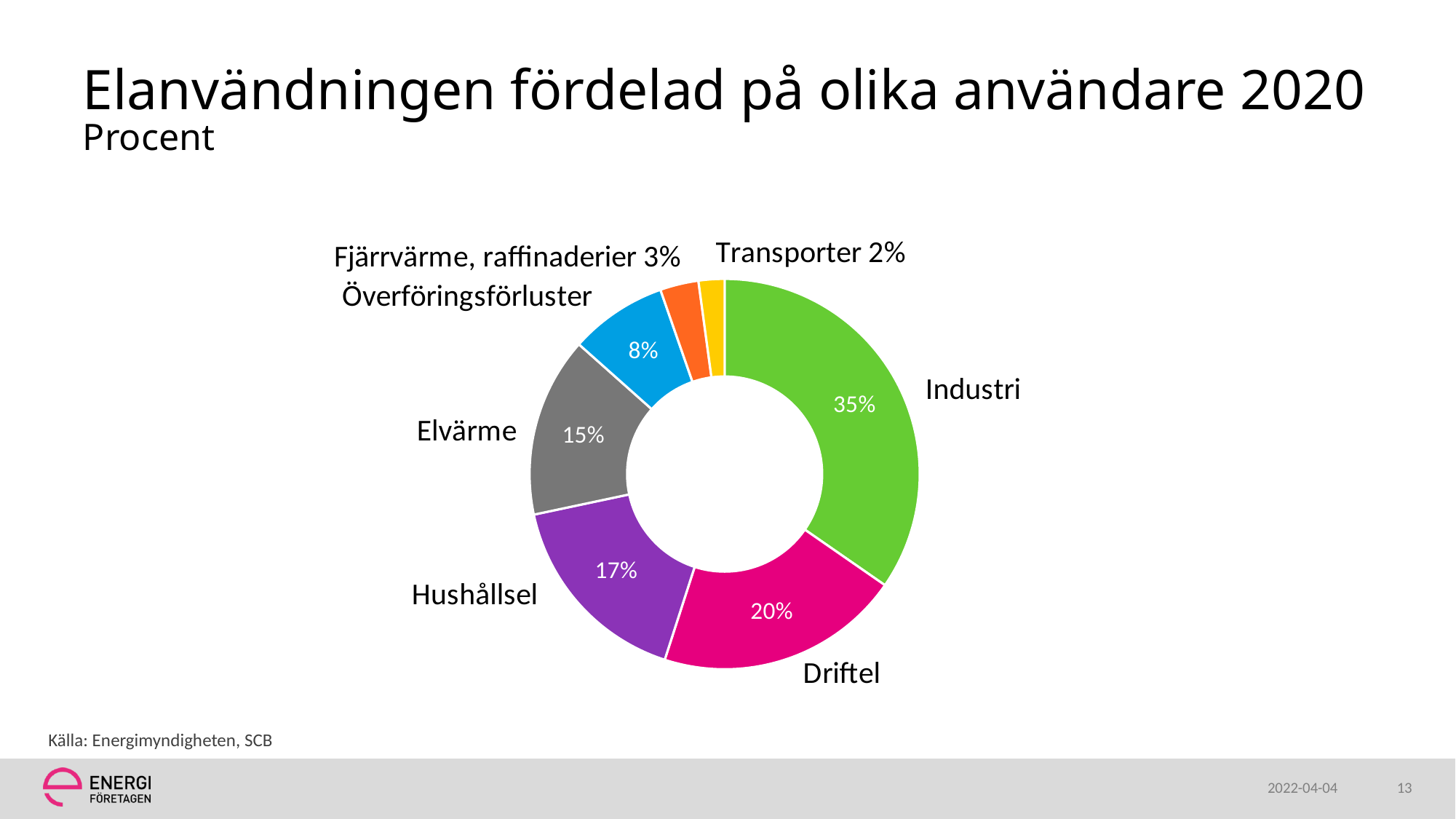
What percentage is shown for Transporter? 2% What share of electricity use does Industri account for? 35% What is the difference in percentage points between Industri and Driftel? 15 Which category has the largest share of the chart? Industri What percentage is shown for Hushållsel? 17% What percentage is shown for Driftel? 20% What percentage is shown for Överföringsförluster? 8% What percentage is shown for Elvärme? 15% Which category has the smallest share of the chart? Transporter Which is larger, the share for Hushållsel or the share for Elvärme? Hushållsel How many categories are shown in the chart? 7 What type of chart is shown on the slide? Pie chart (donut)